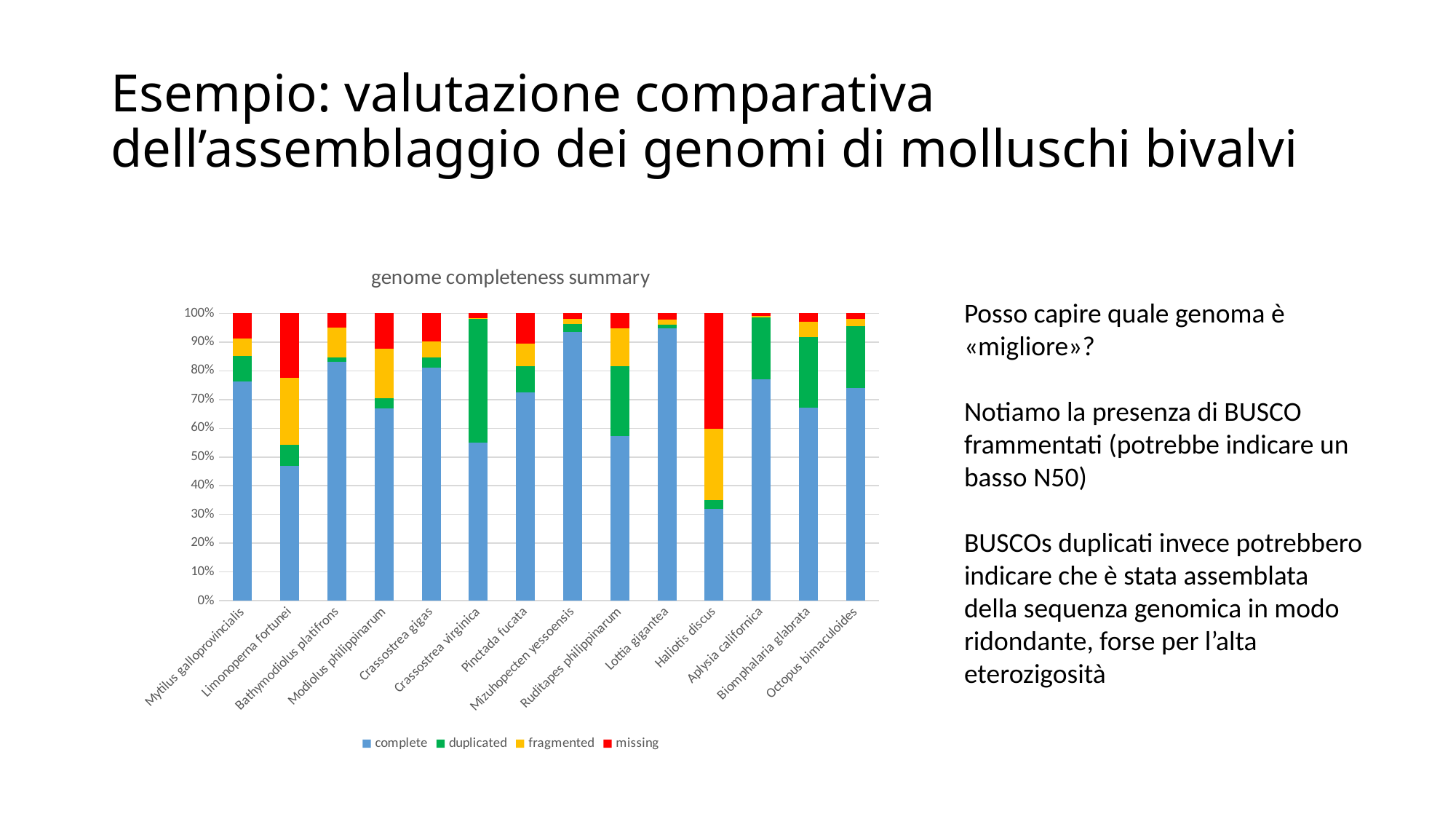
How many series does the chart legend list? 4 What does each stacked bar total on the y axis? 100% How many species (categories) are plotted on the x axis? 14 What is the title of the chart? genome completeness summary Which has a larger 'complete' share, Mytilus galloprovincialis or Limnoperna fortunei? Mytilus galloprovincialis Which species has the lowest 'complete' share? Haliotis discus What kind of chart is shown on the slide? Stacked bar chart Is the 'complete' value for Mytilus galloprovincialis greater or less than 70%? greater Is the 'complete' value for Haliotis discus greater or less than 40%? less Which species has the largest 'missing' share? Haliotis discus Which series is shown in red in the chart? missing Which species has the largest 'duplicated' share? Crassostrea virginica